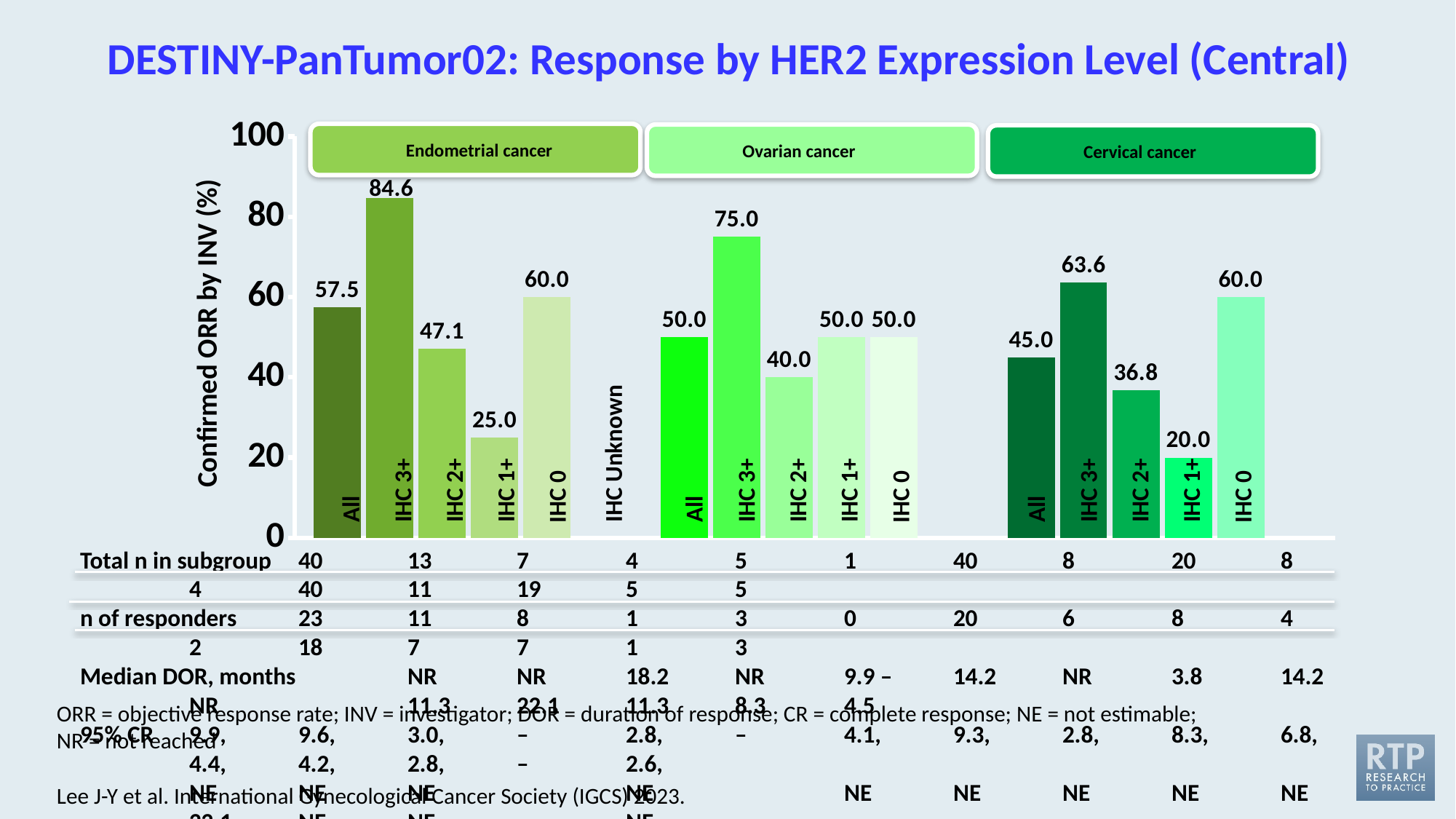
What is the label of the y axis of the chart? Confirmed ORR by INV (%) Is the confirmed ORR for IHC 3+ in the cervical cancer group greater or less than 60? greater What is the confirmed ORR for IHC 2+ in the cervical cancer group? 36.8 What type of chart is shown on the slide? bar chart Which subgroup has the highest confirmed ORR across the whole chart? IHC 3+ (endometrial cancer) What is the confirmed ORR for the All subgroup in the ovarian cancer group? 50.0 What is the difference in confirmed ORR between IHC 3+ and IHC 1+ in the endometrial cancer group? 59.6 Which is larger: the confirmed ORR for IHC 0 in the endometrial cancer group or for IHC 0 in the ovarian cancer group? IHC 0 in the endometrial cancer group What is the confirmed ORR for IHC 3+ in the endometrial cancer group? 84.6 What is the difference in confirmed ORR between IHC 3+ and All in the ovarian cancer group? 25.0 Which subgroup has the lowest confirmed ORR in the cervical cancer group? IHC 1+ How many cancer types are shown in the chart legend? 3